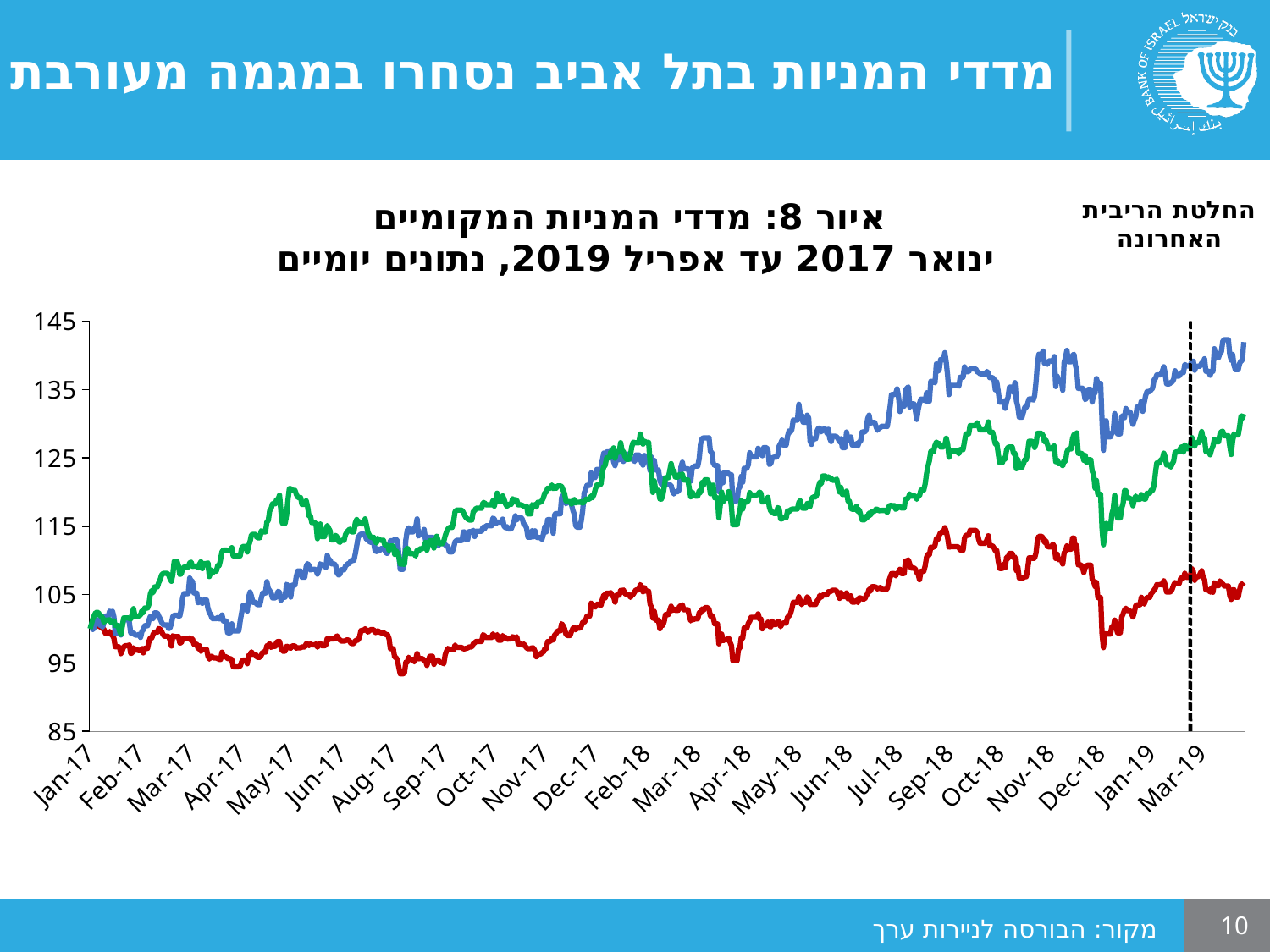
Is the peak of the red line around Sep-18 greater or less than 105? greater Is the value of the blue line at Mar-19 greater or less than 135? greater What does the vertical dashed line near the right of the chart mark, according to the label on the slide? החלטת הריבית האחרונה Which line is lowest at the right end of the chart (Mar-19 onward)? the red line Which line is highest at the right end of the chart (Mar-19 onward)? the blue line Does the blue line overall rise or fall from Jan-17 to Mar-19? rise What kind of chart is shown on the slide? line chart Is the value of the green line at Mar-19 greater or less than 125? greater What are the lowest and highest values shown on the vertical axis? 85 and 145 How many lines are plotted on the chart? 3 At Mar-19, which is higher: the blue line or the red line? the blue line